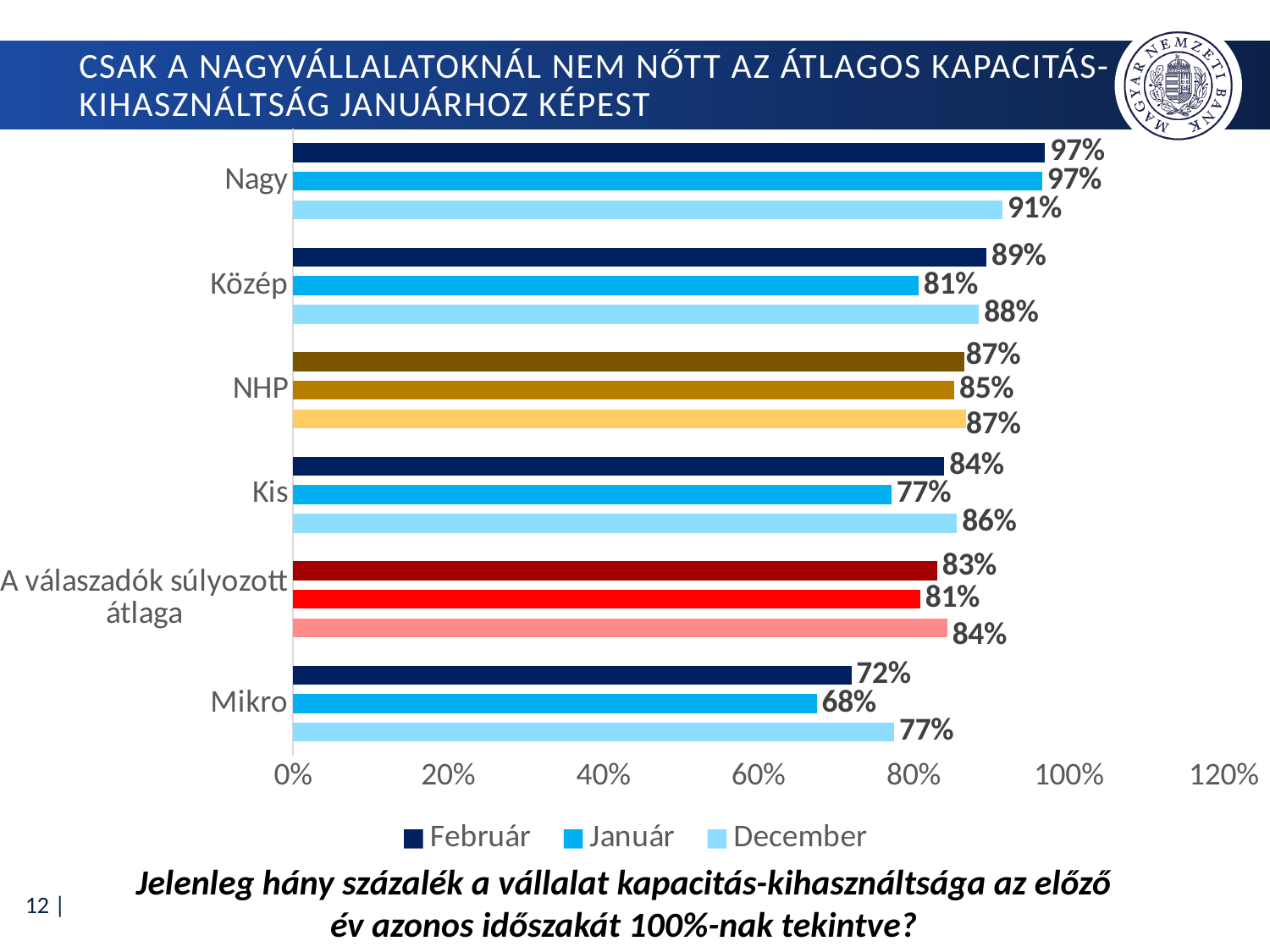
How many categories are shown on the chart? 6 How many series does the legend list? 3 What is the Január value for NHP? 85% Which category has the lowest Január value? Mikro What kind of chart is shown on the slide? Bar chart Which category has the highest December value? Nagy Which is larger for Közép: the Február value or the December value? Február What is the December value for Mikro? 77% What is the difference between the Február and Január values for Kis? 7% What is the difference between the Február and Január values for Mikro? 4% What is the Január value for Közép? 81% What is the Február value for Nagy? 97%